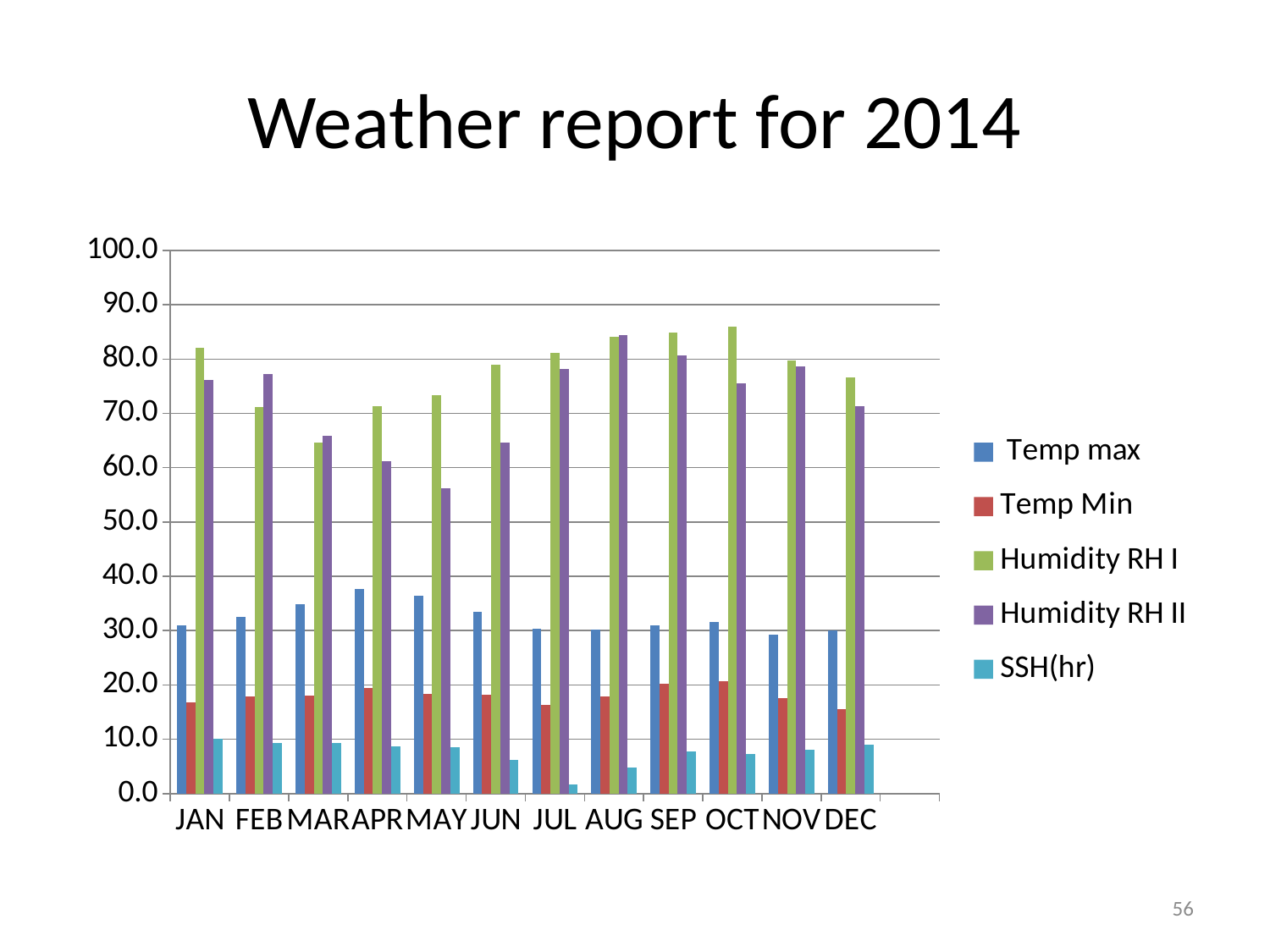
What is the title of the chart? Weather report for 2014 Does the SSH(hr) value rise or fall from JAN to JUL? Fall What kind of chart is shown on the slide? Bar chart In MAY, which is larger: Humidity RH I or Humidity RH II? Humidity RH I Which month has the lowest SSH(hr) value? JUL Is the Humidity RH I value for JAN greater or less than 80? greater How many series does the legend list? 5 Is the Humidity RH II value for MAY greater or less than 60? less Is the Temp max value for APR greater or less than 30? greater Which month has the lowest Humidity RH II value? MAY Which month has the lowest Humidity RH I value? MAR How many months are shown on the x axis? 12